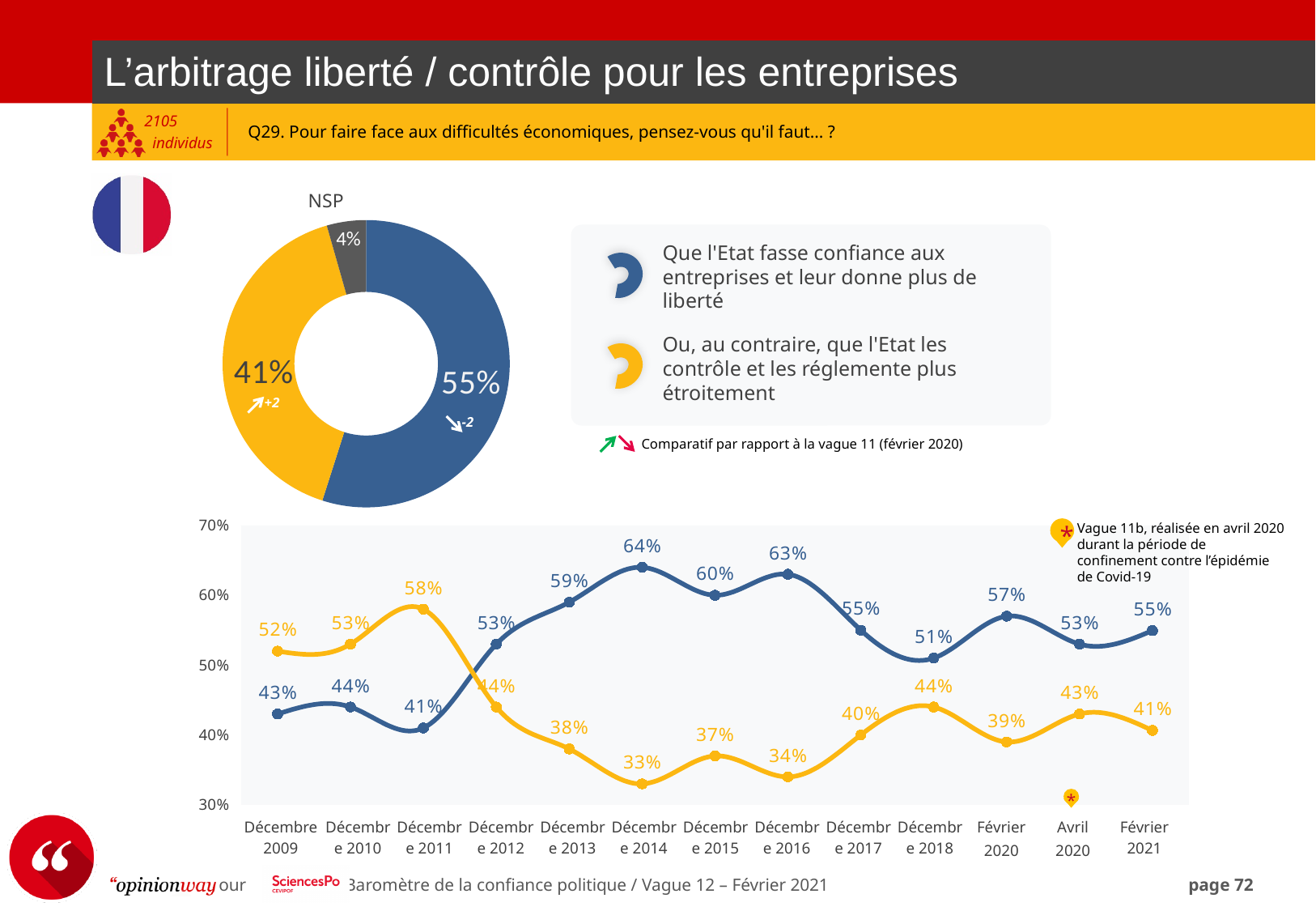
In the donut chart at the top of the slide, what share of respondents say the State should trust companies and give them more freedom (blue slice)? 55% In the line chart at the bottom of the slide, which line has the higher value in Décembre 2010, the blue or the yellow? Yellow What kind of chart is the chart at the bottom of the slide? Line chart In the donut chart at the top of the slide, what is the difference between the blue slice (55%) and the yellow slice (41%)? 14 points In the line chart at the bottom of the slide, does the yellow line rise or fall between Décembre 2011 and Décembre 2014? Fall In the line chart at the bottom of the slide, in which period does the yellow line reach its lowest value? Décembre 2014 In the line chart at the bottom of the slide, what is the value of the yellow line for Décembre 2011? 58% In the line chart at the bottom of the slide, what is the value of the blue line for Décembre 2014? 64% How many time periods are shown on the x axis of the line chart at the bottom of the slide? 13 In the donut chart at the top of the slide, what percentage is shown for NSP? 4% In the line chart at the bottom of the slide, in which period does the blue line reach its highest value? Décembre 2014 In the line chart at the bottom of the slide, what is the difference between the blue line (55%) and the yellow line (41%) in Février 2021? 14 points